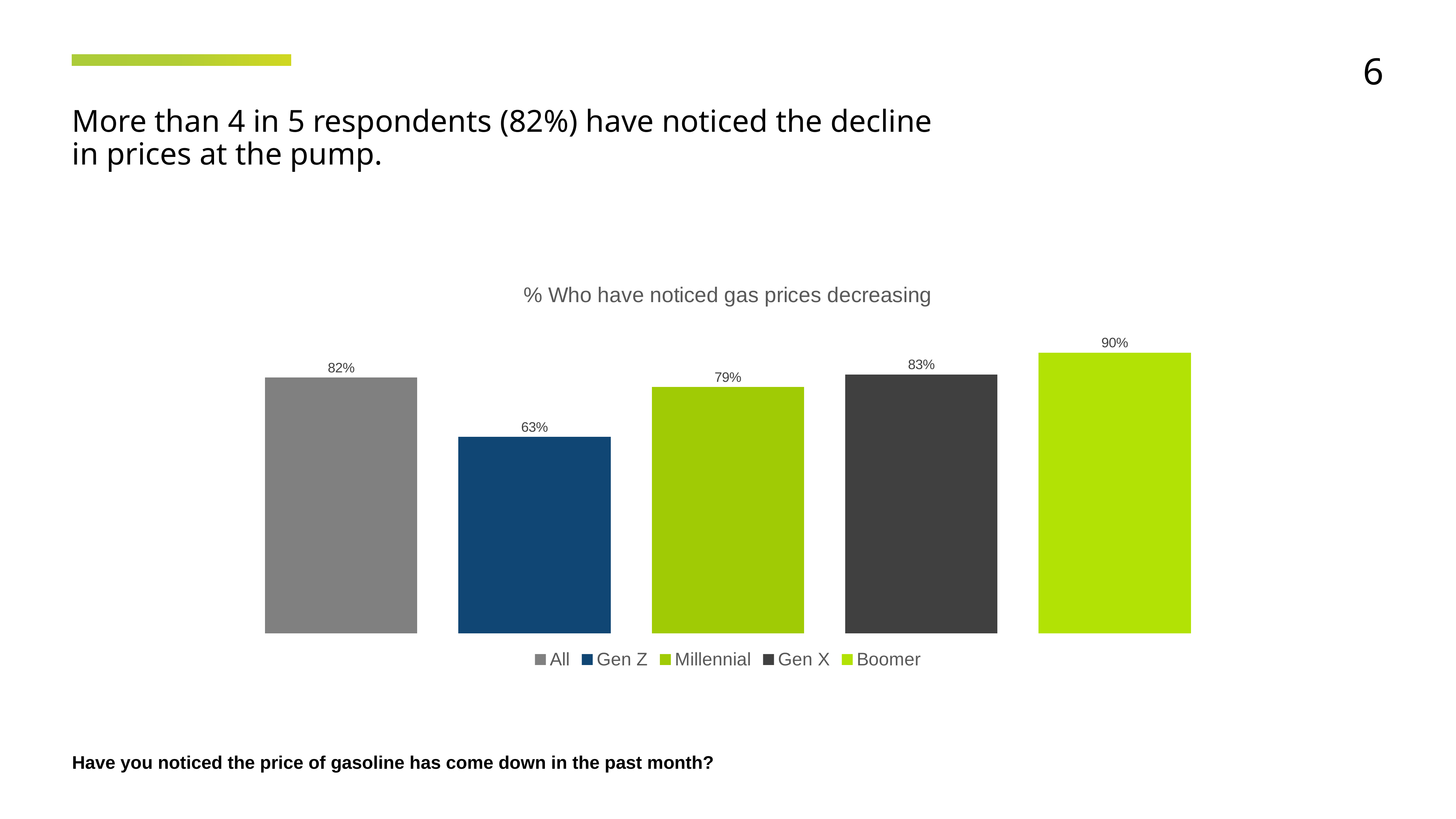
Which group has the highest percentage who have noticed gas prices decreasing? Boomer Which group has the lowest percentage who have noticed gas prices decreasing? Gen Z What is the value shown for Millennial? 79% What kind of chart is shown on the slide? Bar chart Which is larger, the value for Gen X or the value for Millennial? Gen X What is the title of the chart? % Who have noticed gas prices decreasing What is the value shown for Boomer? 90% What is the difference between the Boomer value and the Gen Z value? 27% What is the value shown for Gen Z? 63% What is the difference between the Gen X value and the Millennial value? 4% How many bars are shown in the chart? 5 What percentage of all respondents have noticed gas prices decreasing? 82%